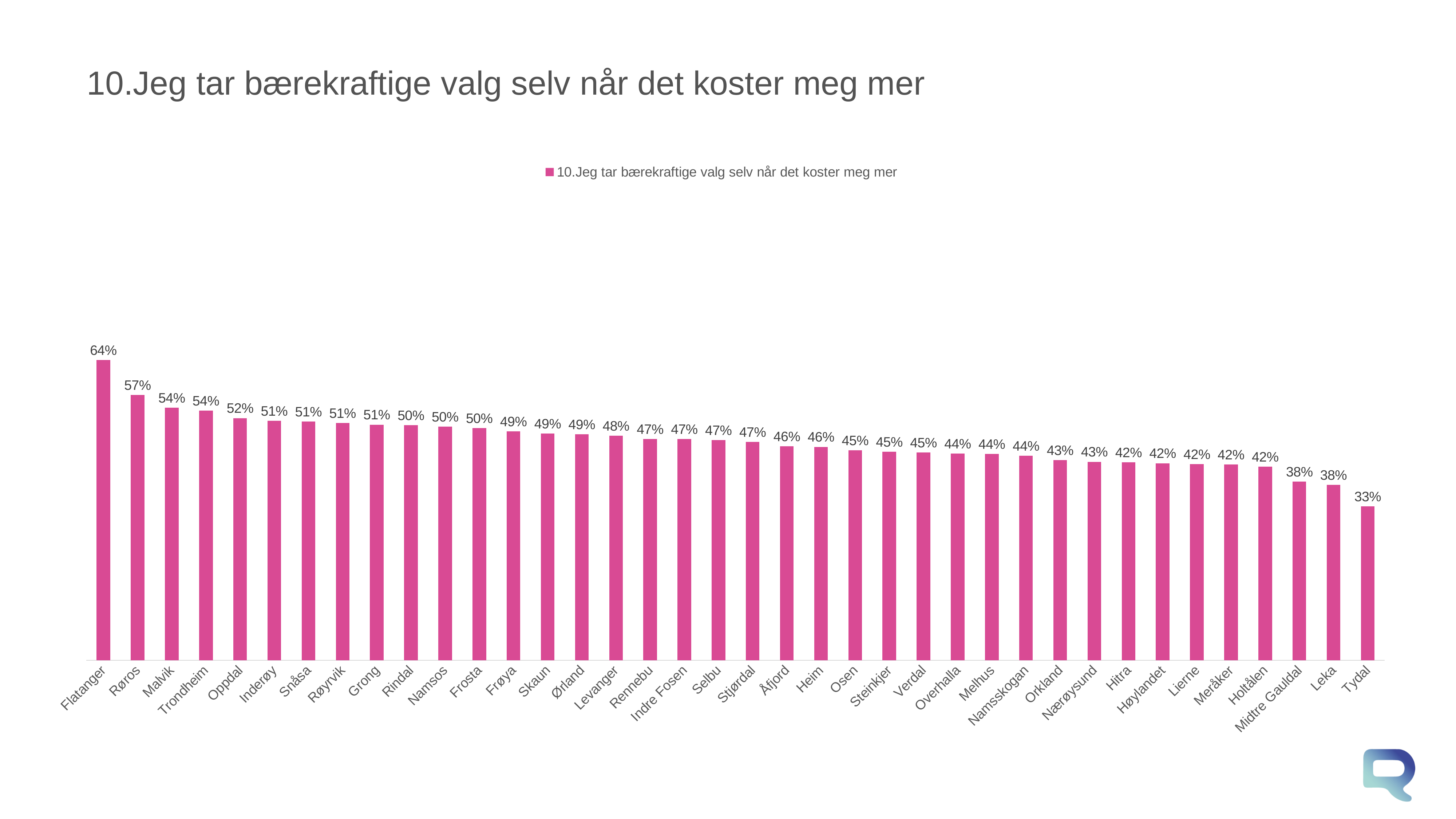
What is the difference between the values for Flatanger and Røros? 7% What is the difference between the values for Leka and Tydal? 5% Do the values rise or fall from left to right along the x axis? Fall What is the value for Steinkjer? 45% How many municipalities are shown on the x axis? 38 What kind of chart is shown on the slide? Bar chart What is the value for Flatanger? 64% What is the value for Tydal? 33% Which municipality has the highest value? Flatanger Which municipality has the lowest value? Tydal What is the value for Trondheim? 54% Which has a larger value, Oppdal or Orkland? Oppdal